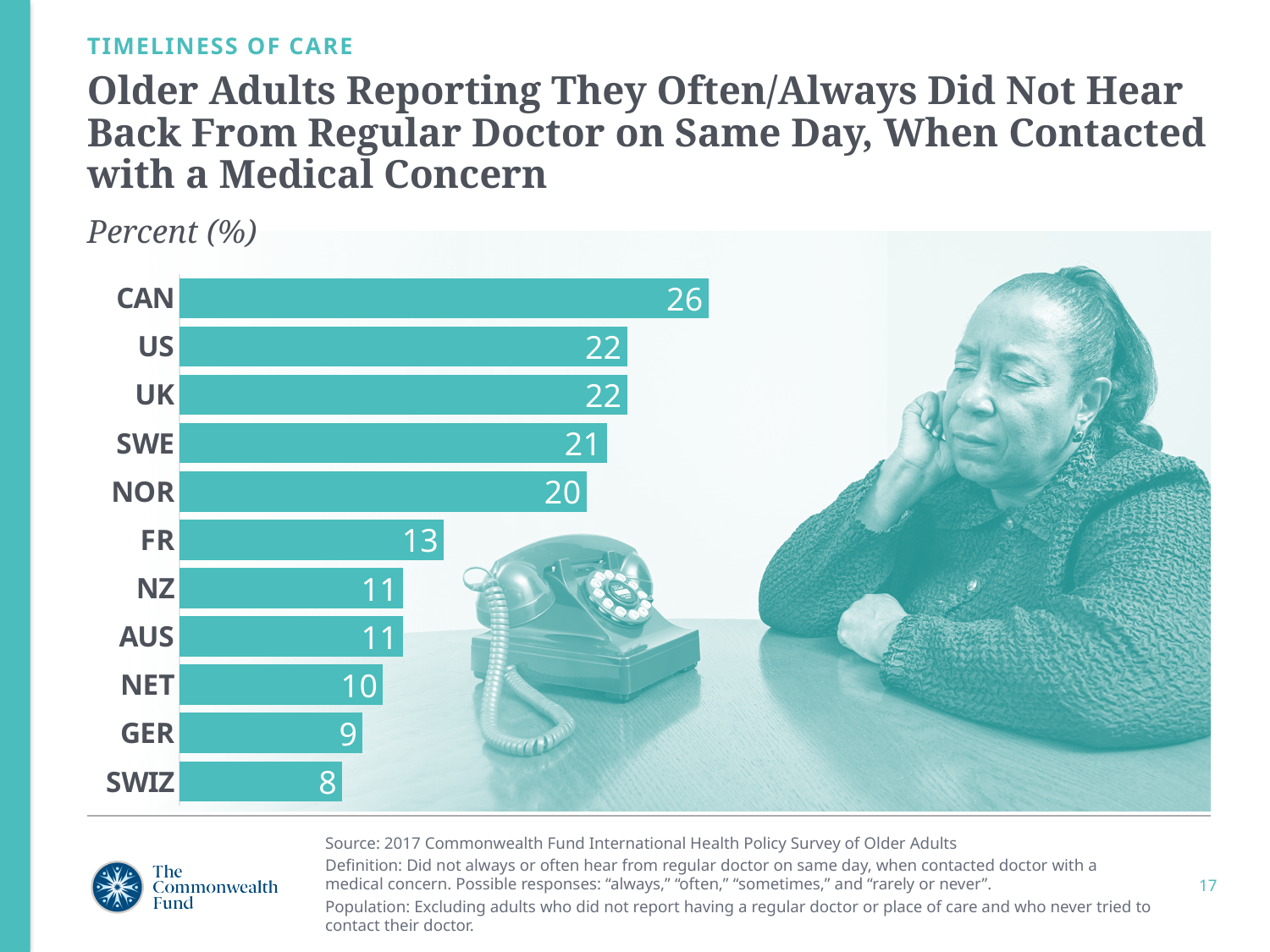
What is the difference between the values for FR and GER? 4 What is the value for SWIZ? 8 Which is larger, the value for SWE or the value for NET? SWE Which country has the lowest value? SWIZ What unit is indicated for the values in the chart? Percent (%) What is the value for CAN? 26 What kind of chart is shown on the slide? Bar chart What is the difference between the values for CAN and US? 4 What is the value for NOR? 20 How many countries are shown in the chart? 11 Which country has the highest value? CAN What is the value for FR? 13